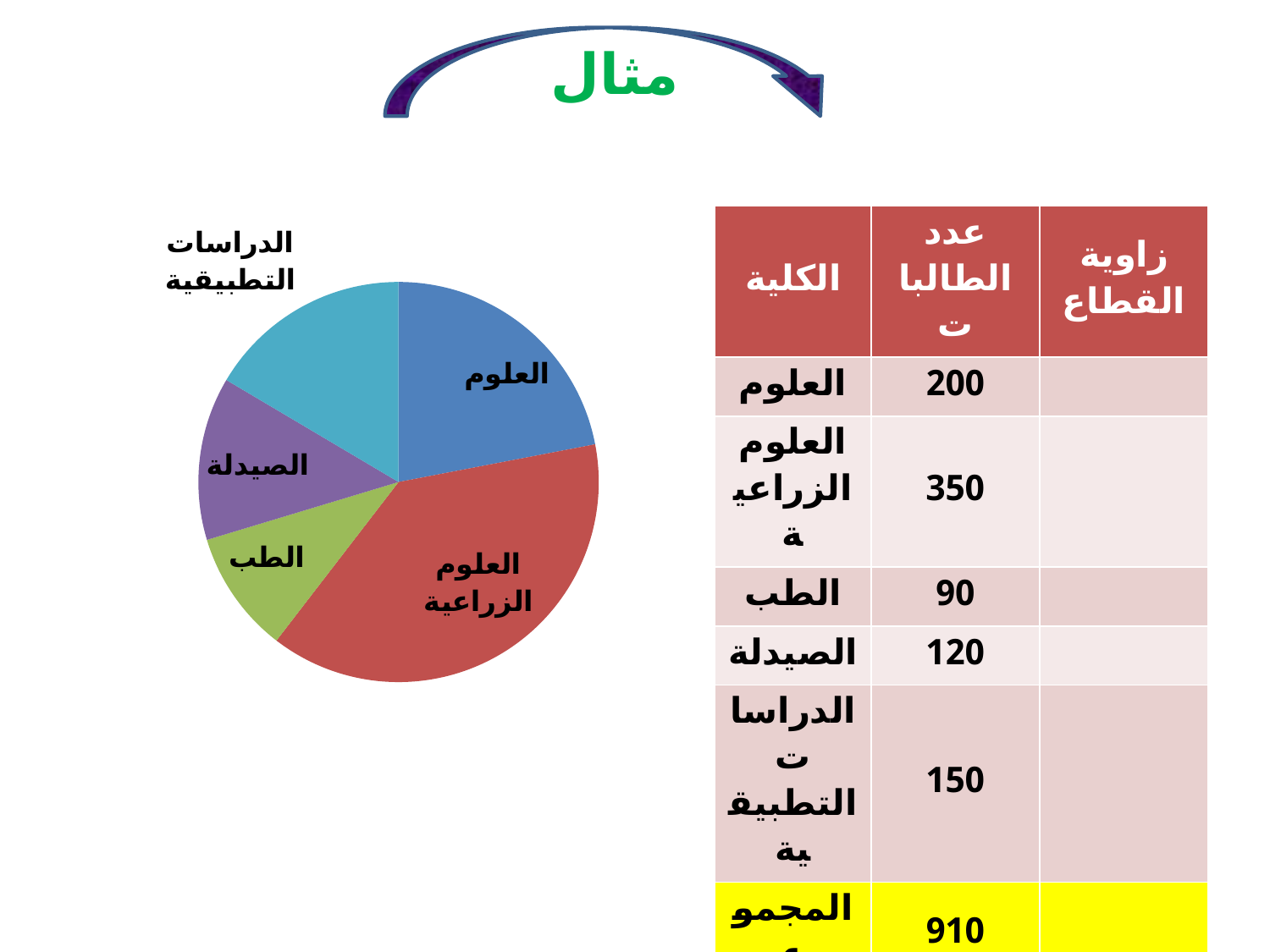
What colour is the العلوم slice in the pie chart? blue Which college has the largest slice in the pie chart? العلوم الزراعية Which college has the smallest slice in the pie chart? الطب According to the table on the slide, how many students does العلوم الزراعية have? 350 According to the table on the slide, how many students does الصيدلة have? 120 How many slices does the pie chart have? 5 What kind of chart is shown on the slide? pie chart What is the difference in student numbers between العلوم الزراعية and العلوم? 150 According to the table on the slide, how many students does الدراسات التطبيقية have? 150 Which slice is larger in the pie chart, العلوم or الدراسات التطبيقية? العلوم Which slice is larger in the pie chart, الصيدلة or الطب? الصيدلة What is the total number of students shown in the table (المجموع)? 910